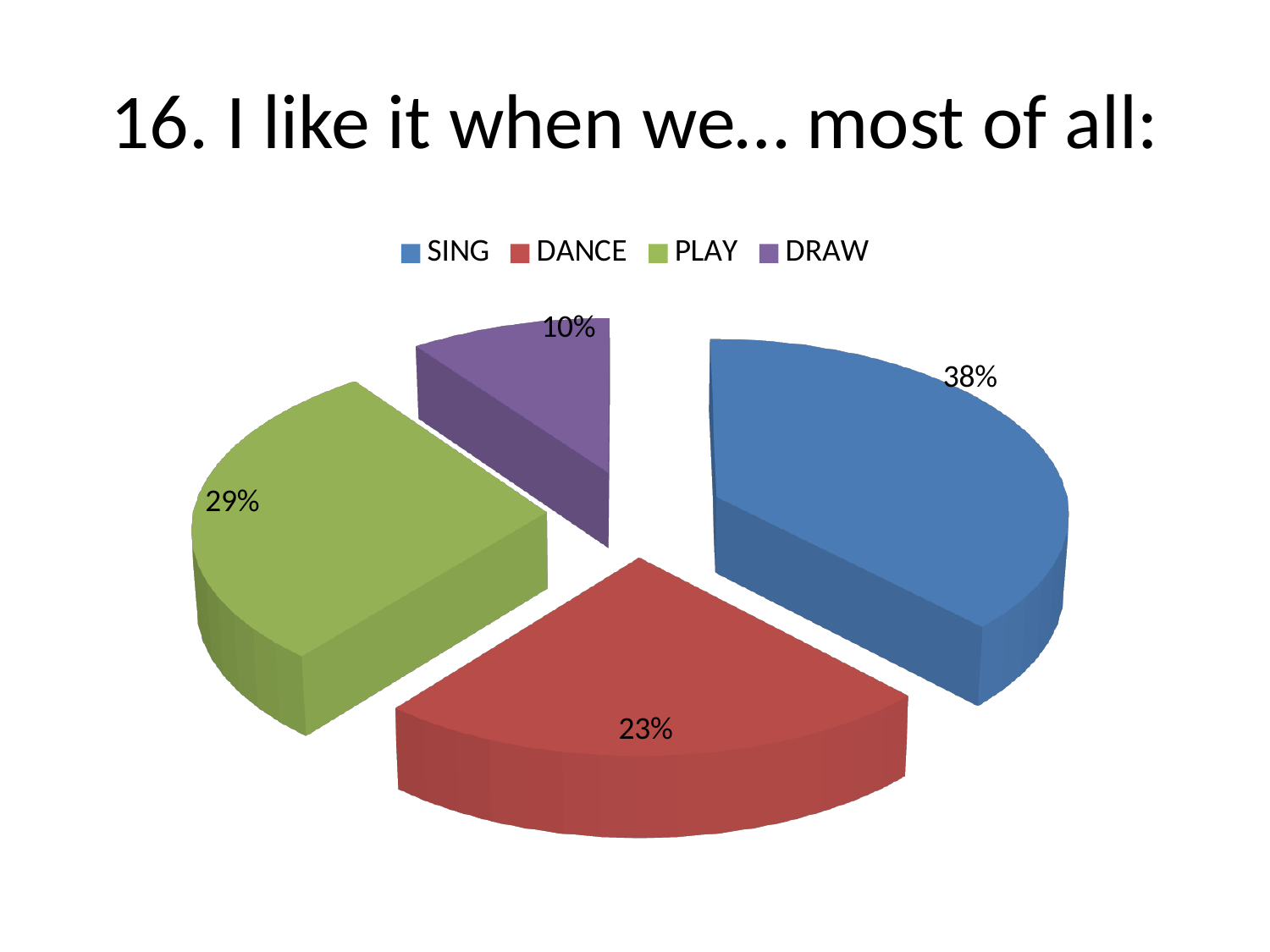
How many categories does the pie chart have? 4 What colour is the SING slice? blue What percentage of the pie is DRAW? 10% Which category has the largest share of the pie? SING What percentage of the pie is PLAY? 29% What percentage of the pie is DANCE? 23% What is the difference in percentage points between PLAY and DANCE? 6 What percentage of the pie is SING? 38% Which category has the smallest share of the pie? DRAW Which is larger, the share for PLAY or the share for DANCE? PLAY What is the difference in percentage points between SING and DRAW? 28 What kind of chart is shown on the slide? pie chart